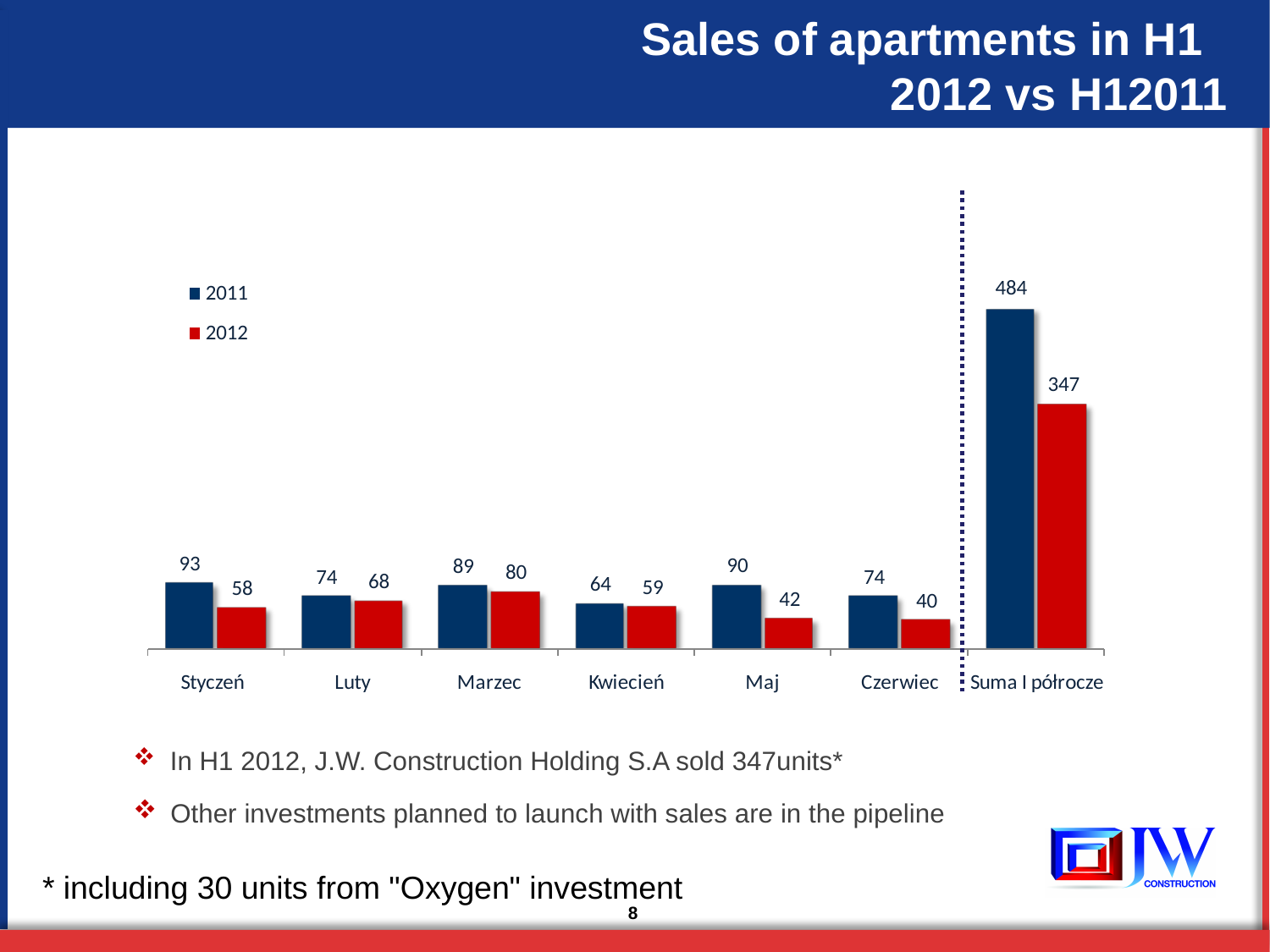
Which colour represents the 2012 series in the legend? Red What was the value for 2012 in Czerwiec? 40 What is the difference between the 2011 and 2012 values for Suma I półrocze? 137 Which is larger in Marzec, the 2011 value or the 2012 value? 2011 What was the value for 2011 in Styczeń? 93 Among the monthly categories (excluding Suma I półrocze), which month has the highest 2011 value? Styczeń What kind of chart is shown on the slide? Bar chart What was the value for 2012 in Suma I półrocze? 347 What is the difference between the 2011 and 2012 values for Maj? 48 How many series does the legend list? 2 Among the monthly categories (excluding Suma I półrocze), which month has the lowest 2012 value? Czerwiec How many categories are shown on the x axis? 7